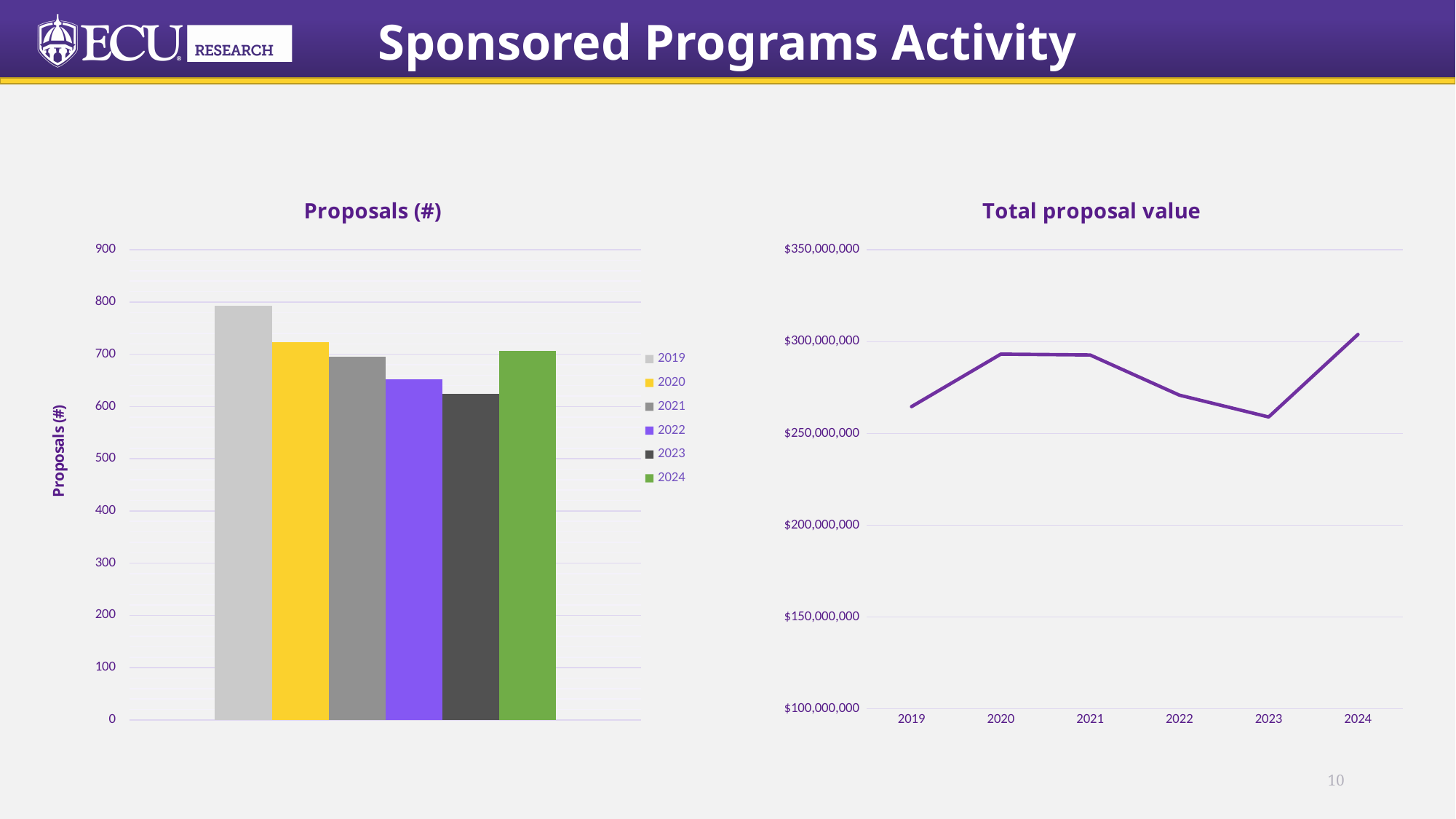
What kind of chart is the "Total proposal value" chart? line chart In the "Proposals (#)" chart, how many entries does the legend list? 6 What kind of chart is the "Proposals (#)" chart? bar chart In the "Proposals (#)" chart, which year has the highest number of proposals? 2019 In the "Proposals (#)" chart, is the value for 2019 greater or less than 700? greater In the "Proposals (#)" chart, which is larger, the value for 2020 or the value for 2021? 2020 In the "Total proposal value" chart, is the value for 2024 greater or less than $300,000,000? greater What is the label on the vertical axis of the "Proposals (#)" chart? Proposals (#) In the "Proposals (#)" chart, is the value for 2022 greater or less than 700? less In the "Total proposal value" chart, which year has the highest total proposal value? 2024 In the "Total proposal value" chart, how many years are plotted along the x axis? 6 In the "Proposals (#)" chart, which year has the lowest number of proposals? 2023